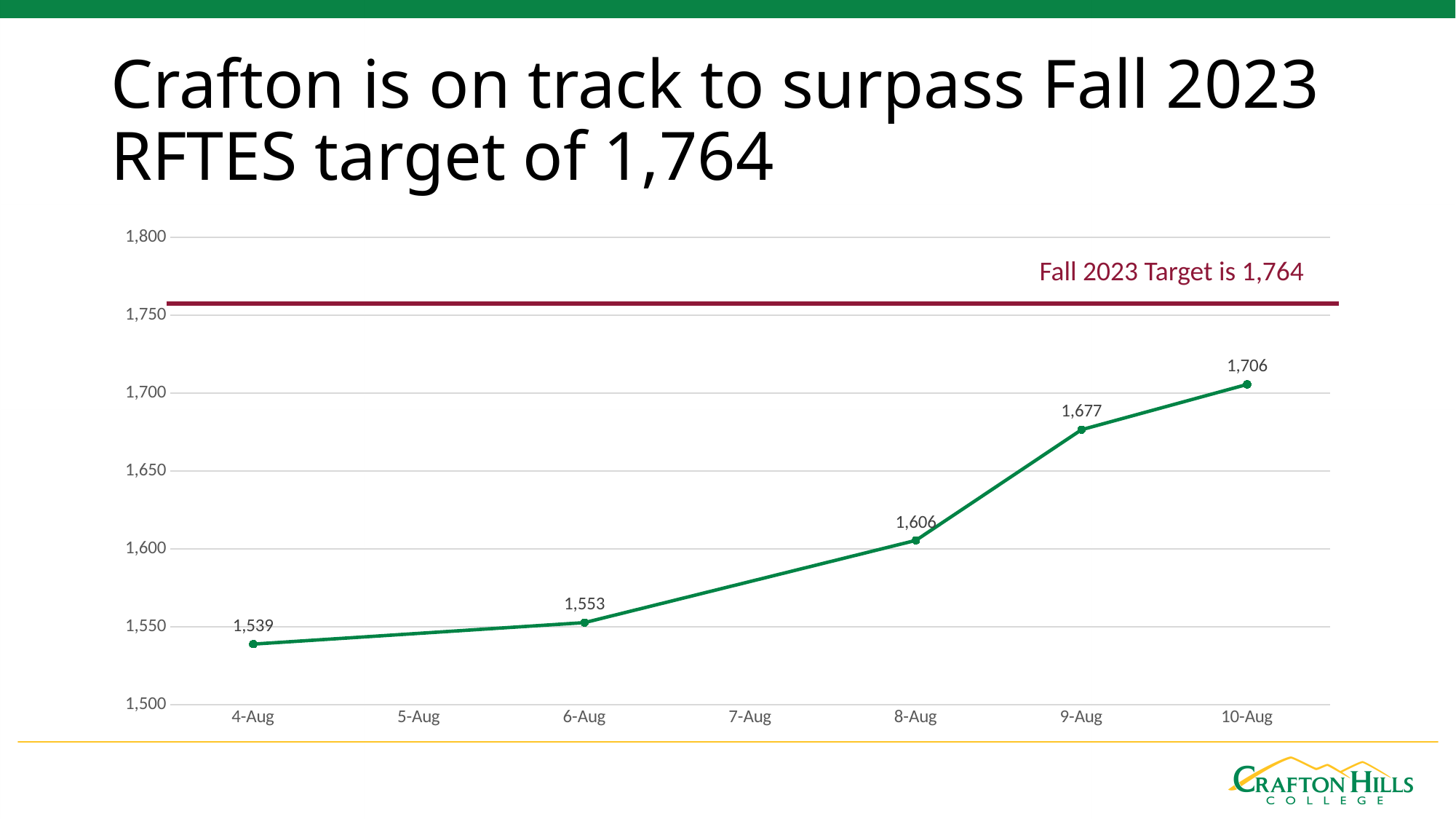
Do the RFTES values rise or fall from 4-Aug to 10-Aug? rise What is the RFTES value on 8-Aug? 1,606 What is the difference between the RFTES values on 9-Aug and 8-Aug? 71 What is the RFTES value on 10-Aug? 1,706 What is the RFTES value on 4-Aug? 1,539 On which date is the RFTES value highest? 10-Aug What kind of chart is shown on the slide? line chart Which is larger, the value on 6-Aug or the value on 8-Aug? 8-Aug What is the RFTES value on 9-Aug? 1,677 What is the difference between the RFTES values on 10-Aug and 4-Aug? 167 How many data points are plotted on the line? 5 On which date is the RFTES value lowest? 4-Aug